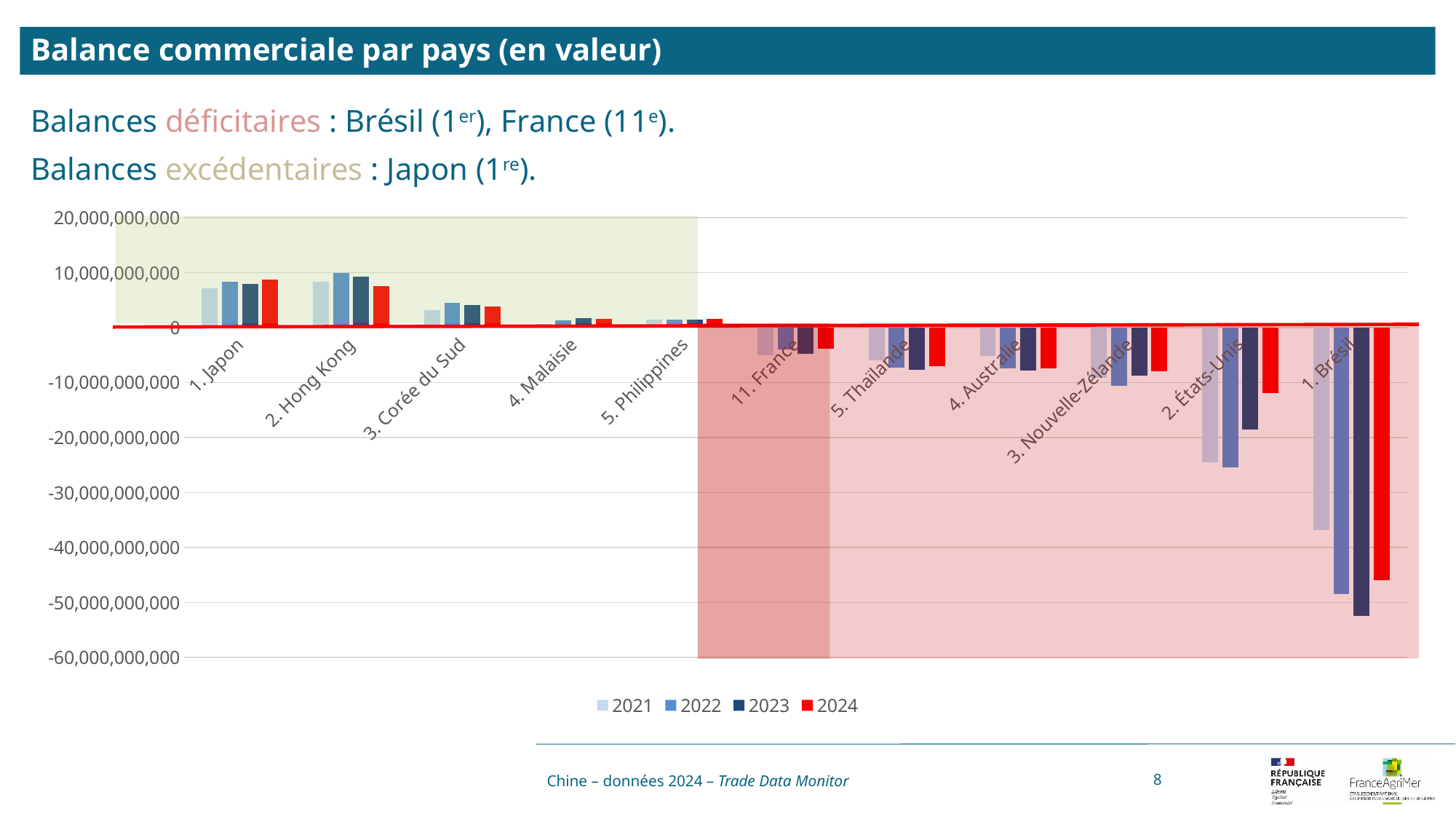
How many series does the legend list? 4 Which country has the highest value for 2024? 1. Japon Is the 2024 value for 1. Brésil greater or less than -40,000,000,000? less Is the 2022 value for 2. États-Unis greater or less than -20,000,000,000? less Which is larger, the 2023 value for 1. Brésil or the 2023 value for 2. États-Unis? 2. États-Unis How many countries are shown on the x axis of the chart? 11 What is the title of the chart slide? Balance commerciale par pays (en valeur) Is the 2023 value for 1. Brésil greater or less than -50,000,000,000? less What kind of chart is shown on the slide? bar chart Which country has the lowest value for 2023? 1. Brésil Which country has the lowest value for 2024? 1. Brésil